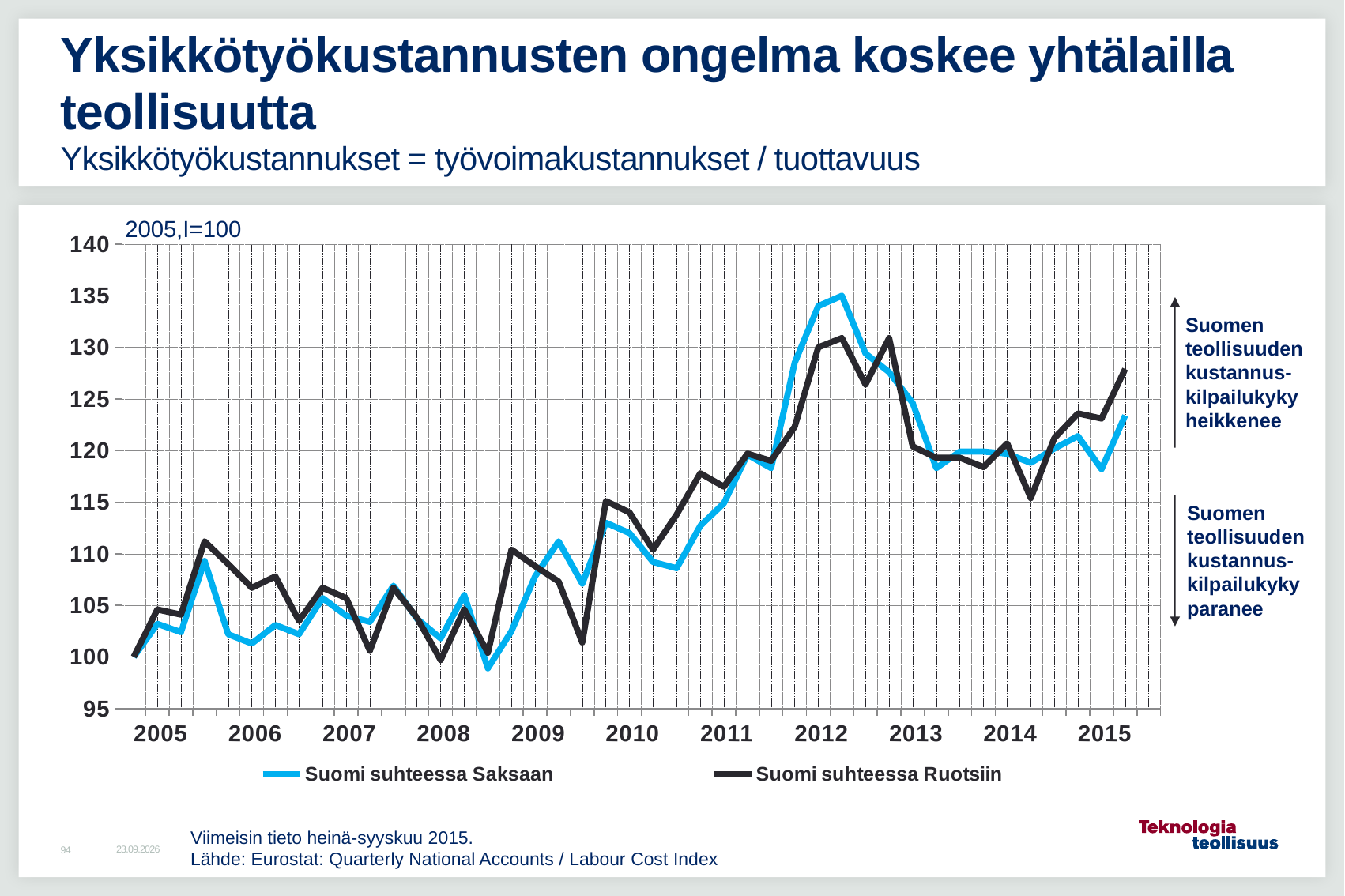
Is the lowest value of Suomi suhteessa Ruotsiin during 2014 greater or less than 120? less How many series does the legend list? 2 Do both series generally rise or fall between 2008 and 2012? rise Is the value of Suomi suhteessa Ruotsiin at the end of 2015 greater or less than 125? greater Is the value of Suomi suhteessa Saksaan at the end of 2015 greater or less than 125? less At the end of 2015, which series is higher: Suomi suhteessa Saksaan or Suomi suhteessa Ruotsiin? Suomi suhteessa Ruotsiin Which base year and index value does the chart use, as printed above the y axis? 2005, I=100 What kind of chart is shown on the slide? line chart At the 2012 peak, which series is higher: Suomi suhteessa Saksaan or Suomi suhteessa Ruotsiin? Suomi suhteessa Saksaan What are the two series named in the legend? Suomi suhteessa Saksaan; Suomi suhteessa Ruotsiin How many years are labelled on the x axis? 11